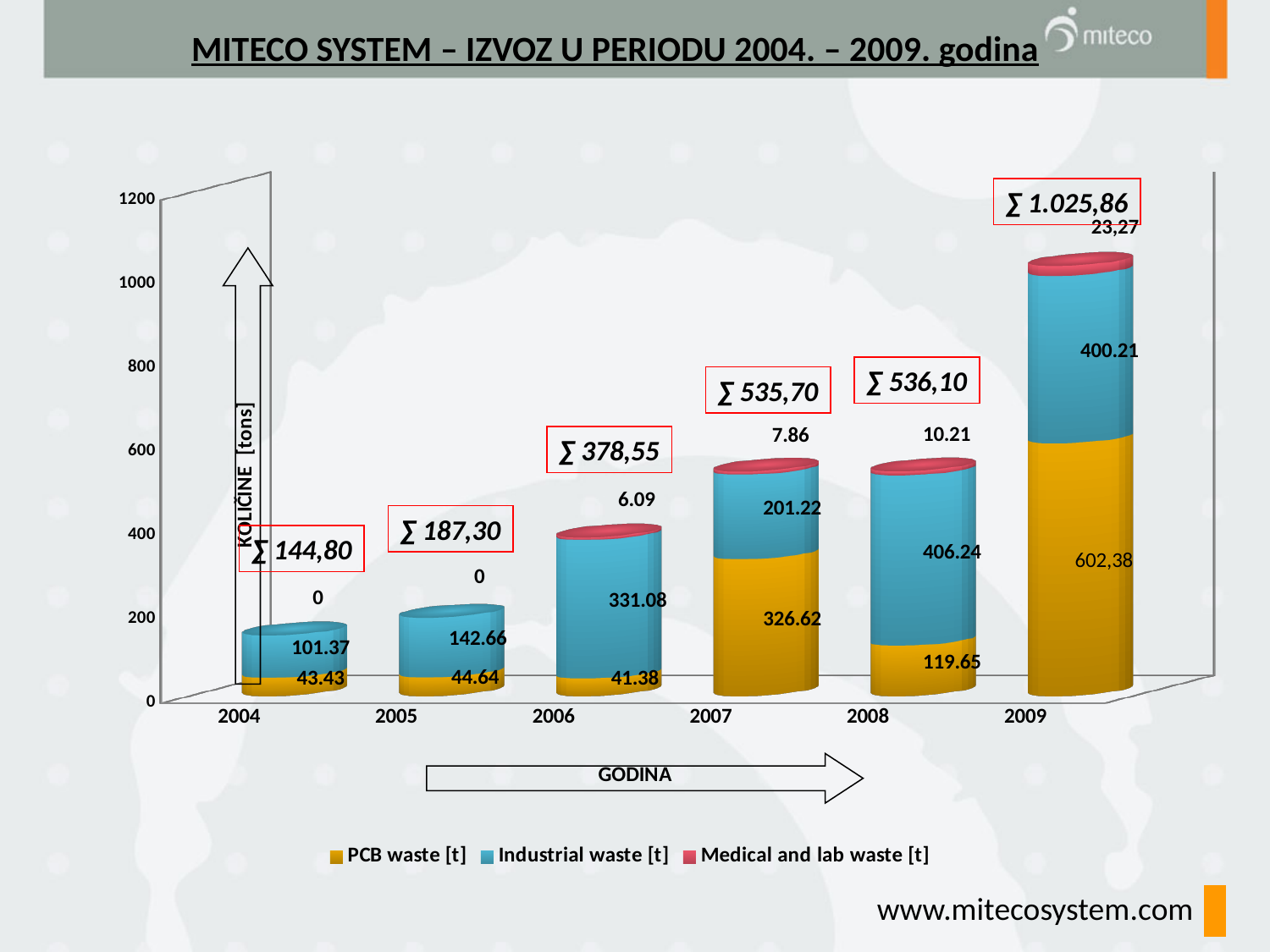
What kind of chart is shown on the slide? Stacked bar chart How many years are shown on the x axis? 6 How many series does the legend list? 3 In 2007, which is larger: PCB waste or Industrial waste? PCB waste What is the PCB waste value for 2007? 326.62 What is the Medical and lab waste value for 2008? 10.21 Which year has the highest PCB waste value? 2009 Which year has the lowest Industrial waste value? 2004 What is the Industrial waste value for 2006? 331.08 What is the total (∑) shown for 2009? 1.025,86 What is the difference between the Medical and lab waste values for 2009 and 2008? 13.06 What is the difference between the Industrial waste values for 2008 and 2007? 205.02